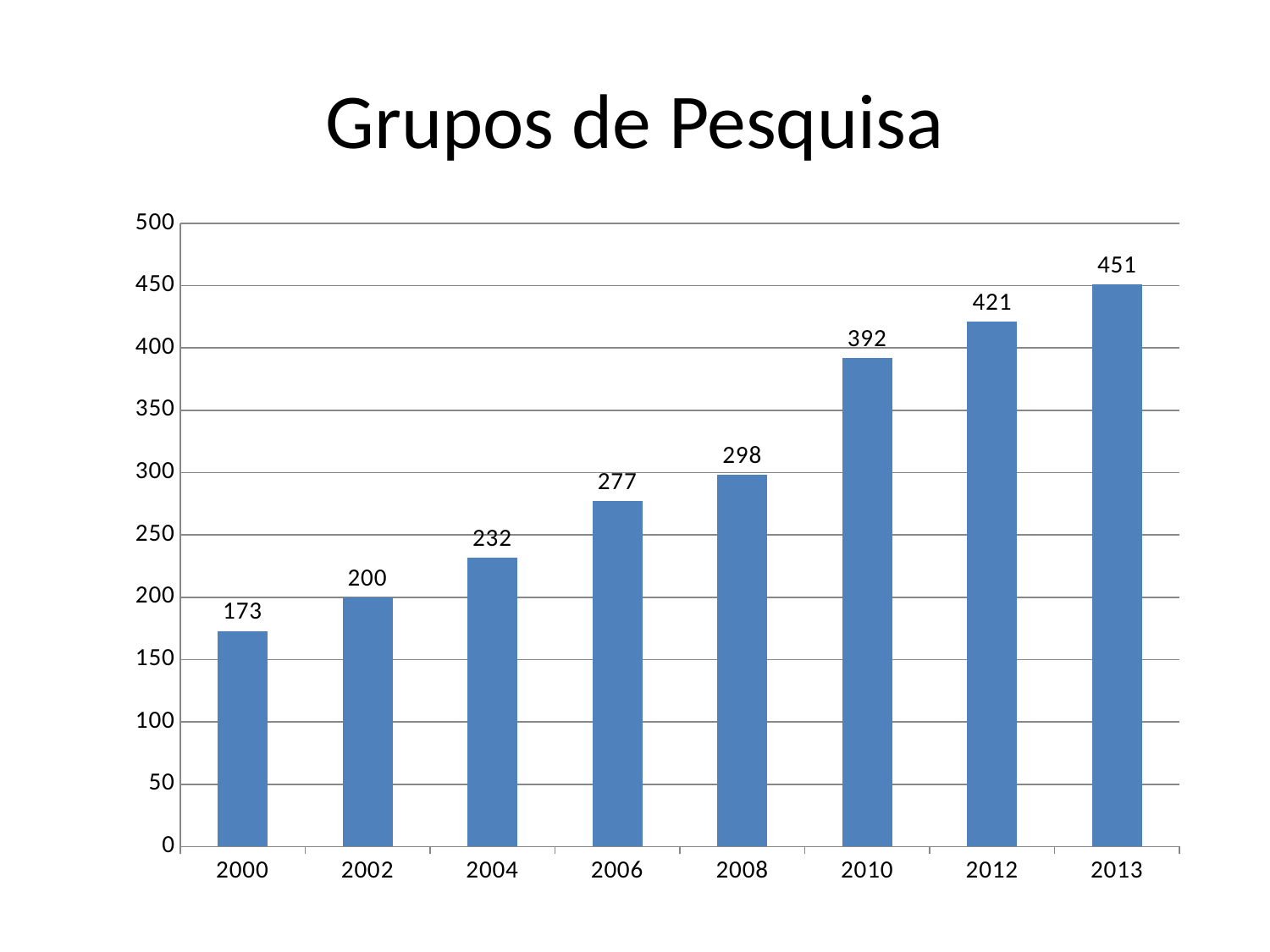
Which is larger, the value for 2006 or the value for 2004? 2006 What is the value for 2008? 298 What is the difference between the values for 2010 and 2008? 94 What is the value for 2012? 421 How many years are shown on the x axis? 8 What is the difference between the values for 2013 and 2000? 278 Is the value for 2010 greater or less than 350? greater What kind of chart is shown? bar chart Do the values rise or fall from 2000 to 2013? rise Which year has the lowest value? 2000 What is the value for 2000? 173 Which year has the highest value? 2013